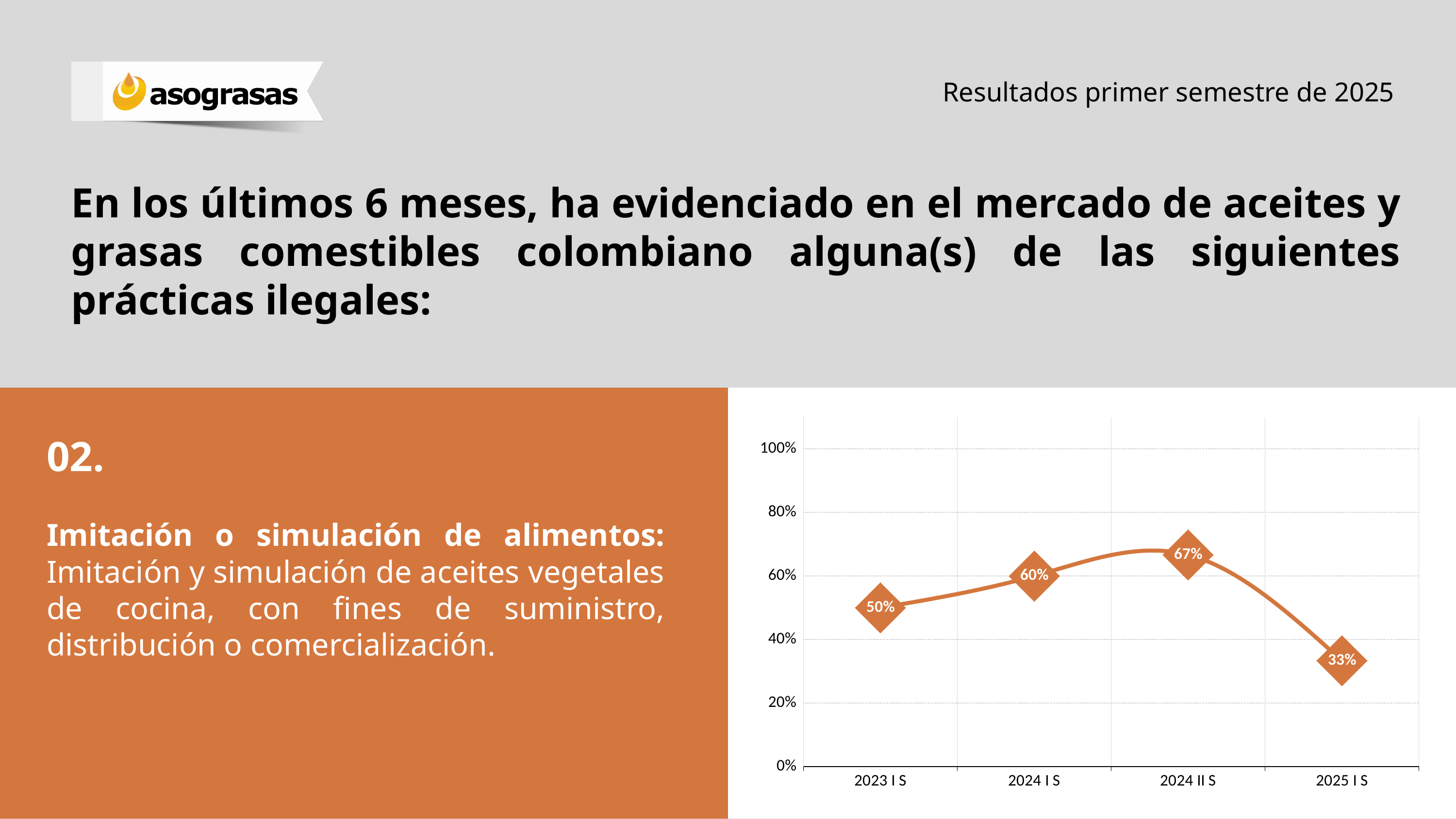
Which is larger, the value for 2023 I S or the value for 2024 I S? 2024 I S What is the value for 2023 I S? 50% What is the value for 2024 I S? 60% Does the value rise or fall from 2024 II S to 2025 I S? fall What is the value for 2025 I S? 33% What is the difference between the values for 2024 II S and 2025 I S? 34% Which period has the highest value? 2024 II S Is the value for 2025 I S greater or less than 40%? less What kind of chart is shown? line chart What is the value for 2024 II S? 67% Which period has the lowest value? 2025 I S How many periods are plotted on the x axis? 4